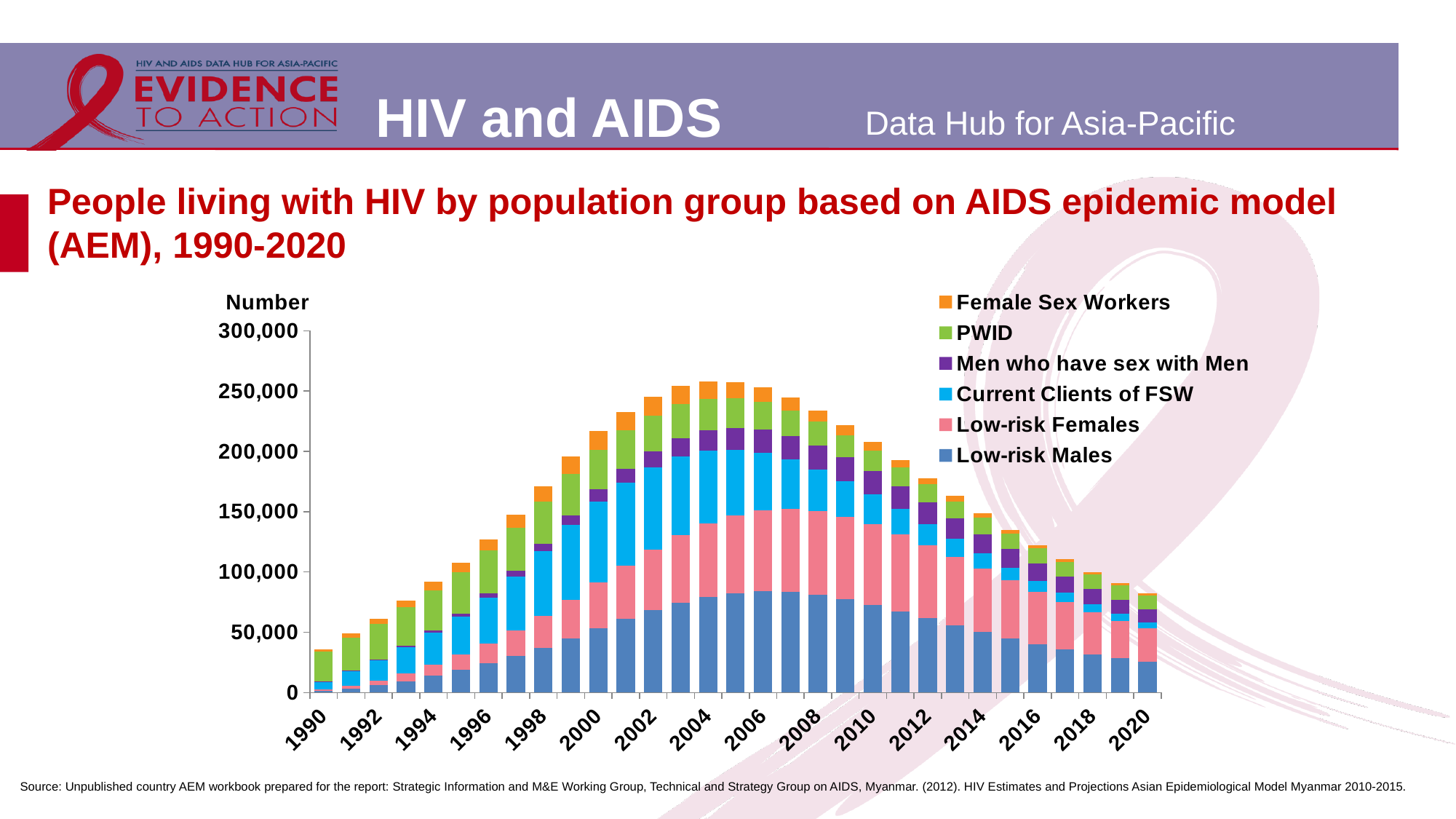
What kind of chart is shown on the slide? Stacked bar chart Is the number of Low-risk Males living with HIV in 2005 greater or less than 100,000? less Which year has a larger total number of people living with HIV, 1998 or 2014? 1998 Is the total number of people living with HIV in 1990 greater or less than 50,000? less Is the total number of people living with HIV in 2000 greater or less than 200,000? greater Which population group is listed first (at the top) in the legend? Female Sex Workers How many years (bars) are plotted in the chart? 31 Which year has the lowest total number of people living with HIV? 1990 What is the label on the vertical axis of the chart? Number Does the total number of people living with HIV rise or fall from 2005 to 2020? fall How many population groups does the legend list? 6